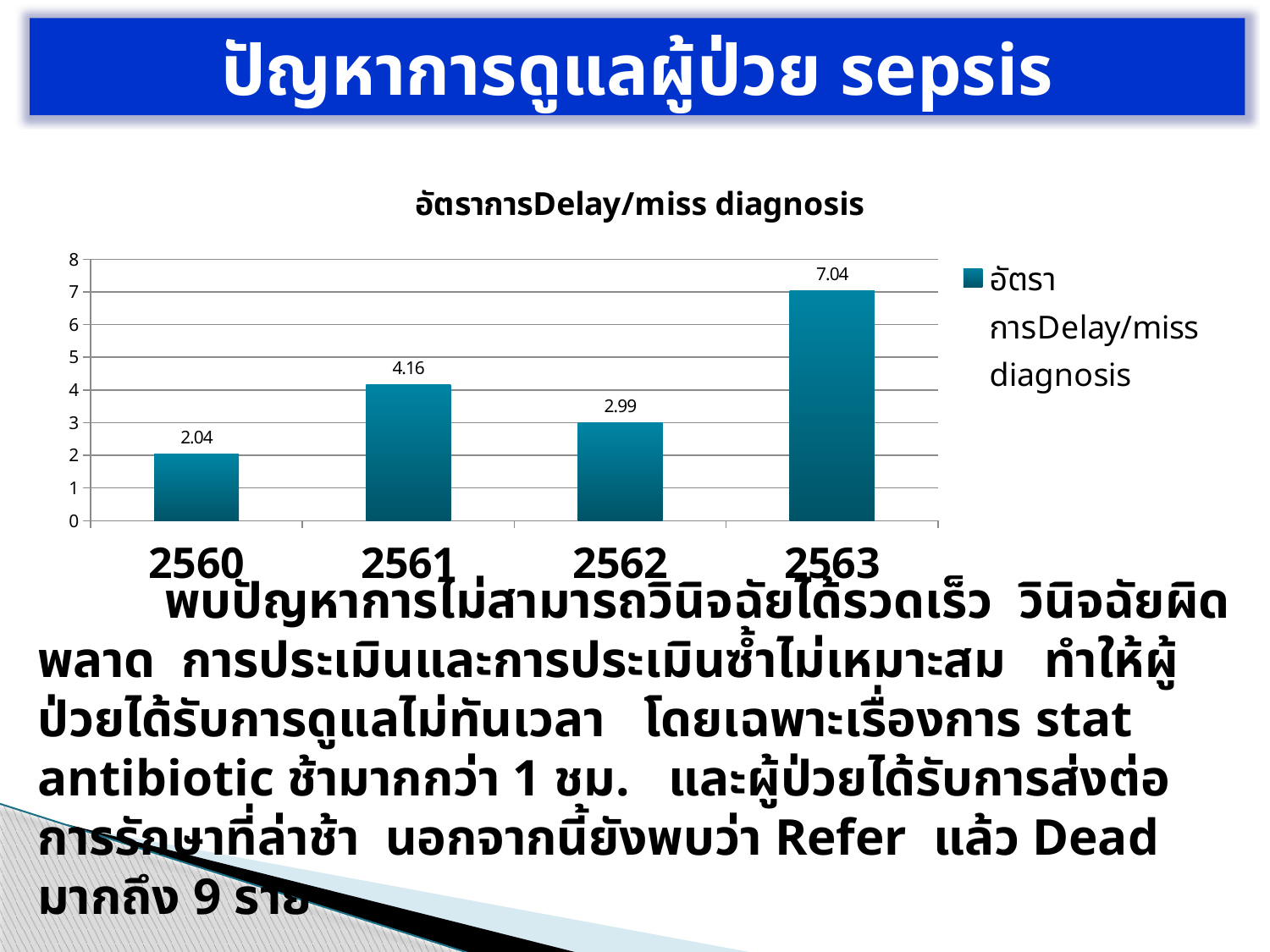
Which year has the lowest value? 2560 What is the value for 2562? 2.99 What is the difference between the values for 2563 and 2560? 5 What is the value for 2563? 7.04 What is the value for 2560? 2.04 Is the value for 2563 greater or less than 6? greater What is the value for 2561? 4.16 How many years are shown on the x axis? 4 What kind of chart is shown? bar chart Which is larger, the value for 2561 or the value for 2562? 2561 Which year has the highest value? 2563 What is the title of the chart? อัตราการDelay/miss diagnosis